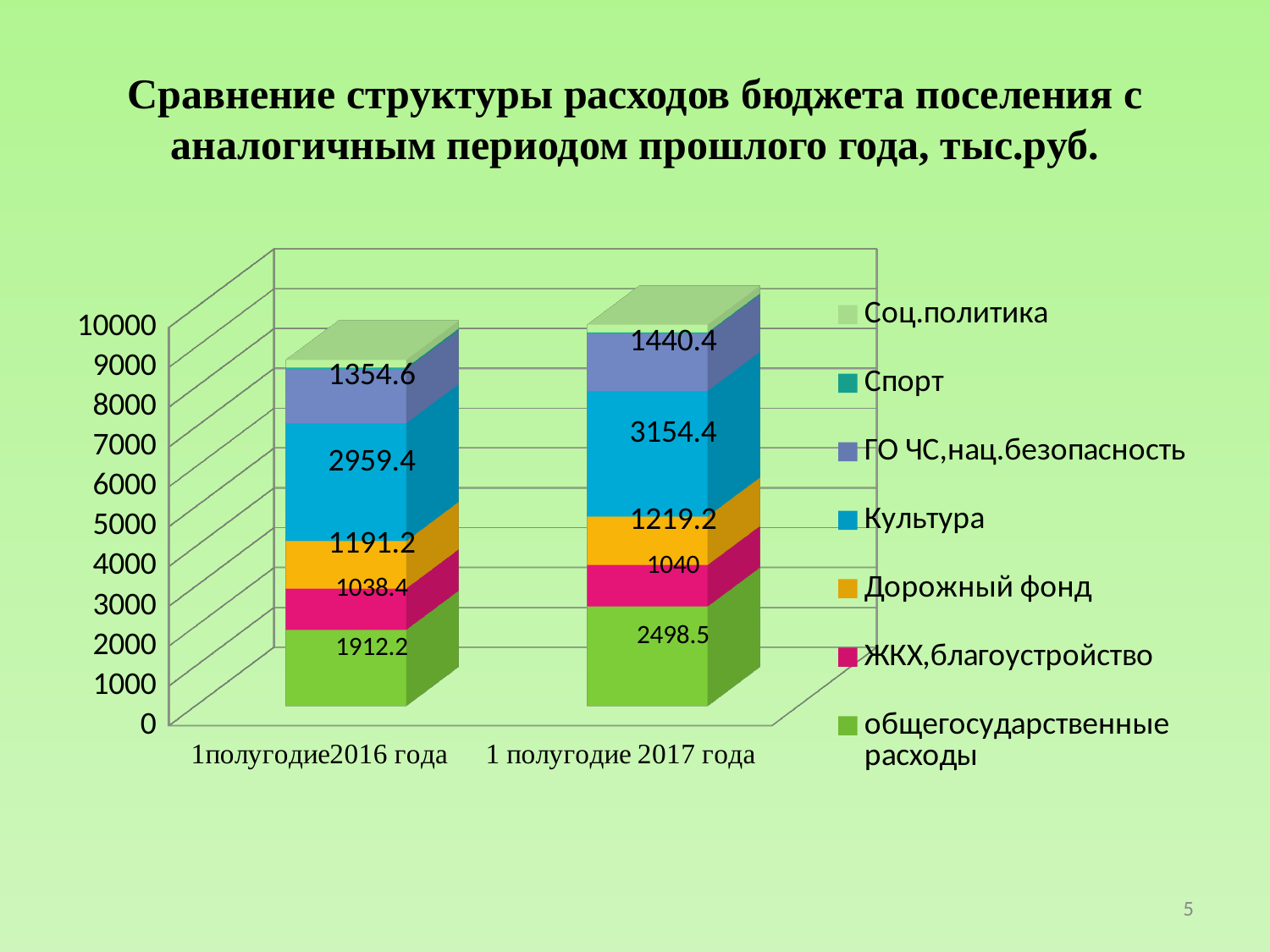
Which series has the largest labelled value in 1полугодие2016 года? Культура What is the value for ЖКХ,благоустройство in 1 полугодие 2017 года? 1040 What is the difference between the Культура values for 1 полугодие 2017 года and 1полугодие2016 года? 195 Which is larger: ГО ЧС,нац.безопасность in 1полугодие2016 года or in 1 полугодие 2017 года? 1 полугодие 2017 года What is the difference between the общегосударственные расходы values for 1 полугодие 2017 года and 1полугодие2016 года? 586.3 How many series does the legend list? 7 How many categories are shown on the x axis? 2 What is the value for общегосударственные расходы in 1полугодие2016 года? 1912.2 What is the value for Дорожный фонд in 1 полугодие 2017 года? 1219.2 What type of chart is shown on the slide? stacked bar chart What is the value for ГО ЧС,нац.безопасность in 1полугодие2016 года? 1354.6 What is the value for Культура in 1 полугодие 2017 года? 3154.4